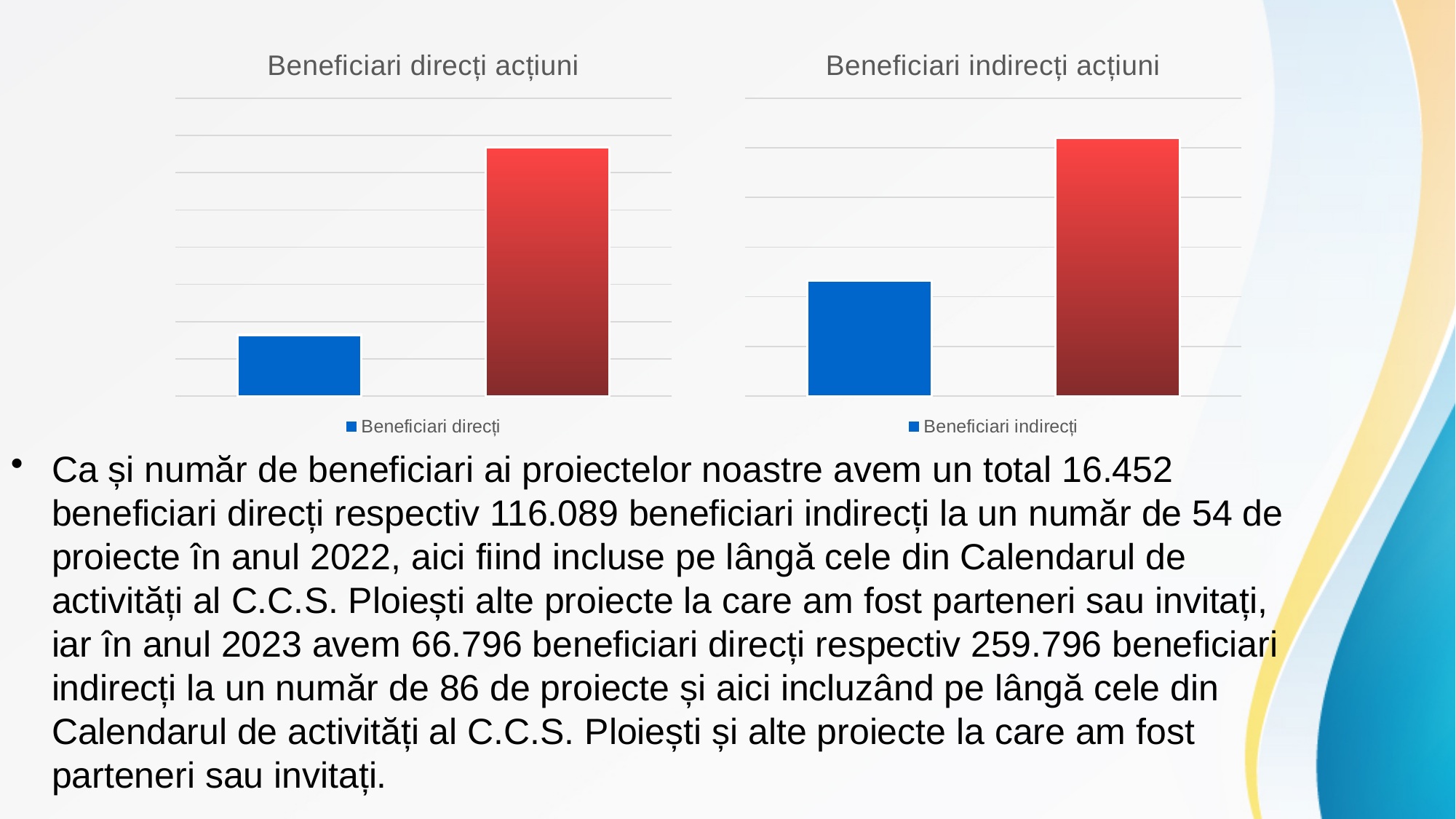
In the chart titled "Beneficiari indirecți acțiuni", which bar is the tallest, the blue one or the red one? the red one What kind of chart is the chart titled "Beneficiari direcți acțiuni"? bar chart What kind of chart is the chart titled "Beneficiari indirecți acțiuni"? bar chart In the chart titled "Beneficiari direcți acțiuni", which bar is the shortest, the blue one or the red one? the blue one What is the title of the left chart on the slide? Beneficiari direcți acțiuni In the chart titled "Beneficiari direcți acțiuni", how many bars are plotted? 2 In the chart titled "Beneficiari indirecți acțiuni", do the bar values rise or fall from left to right? rise In the chart titled "Beneficiari indirecți acțiuni", how many bars are plotted? 2 What legend entry is shown under the right chart on the slide? Beneficiari indirecți In the chart titled "Beneficiari direcți acțiuni", how many entries does the legend list? 1 In the chart titled "Beneficiari direcți acțiuni", is the red bar taller or shorter than the blue bar? taller In the chart titled "Beneficiari indirecți acțiuni", how many entries does the legend list? 1